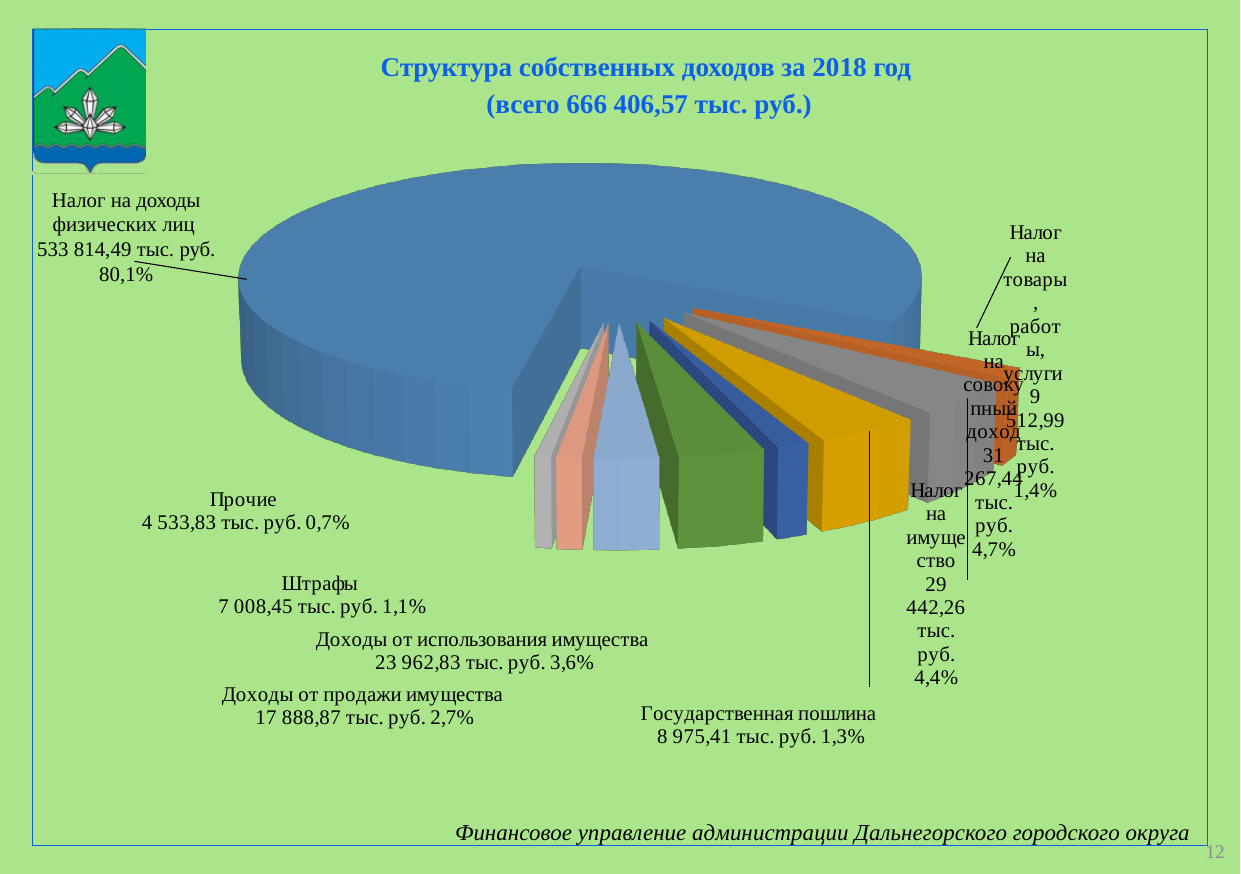
How many slices does the pie chart have? 9 Which category has the largest slice of the pie? Налог на доходы физических лиц What is the title of the chart? Структура собственных доходов за 2018 год (всего 666 406,57 тыс. руб.) Which is larger: "Налог на имущество" or "Налог на совокупный доход"? Налог на совокупный доход What is the value shown for "Доходы от использования имущества"? 23 962,83 тыс. руб. What share of the pie does "Налог на доходы физических лиц" represent? 80,1% What is the value shown for "Государственная пошлина"? 8 975,41 тыс. руб. What share of the pie does "Штрафы" represent? 1,1% Which category has the smallest slice of the pie? Прочие What is the difference in percentage share between "Доходы от использования имущества" and "Доходы от продажи имущества"? 0,9% What is the value shown for "Налог на доходы физических лиц"? 533 814,49 тыс. руб. What kind of chart is shown on the slide? pie chart